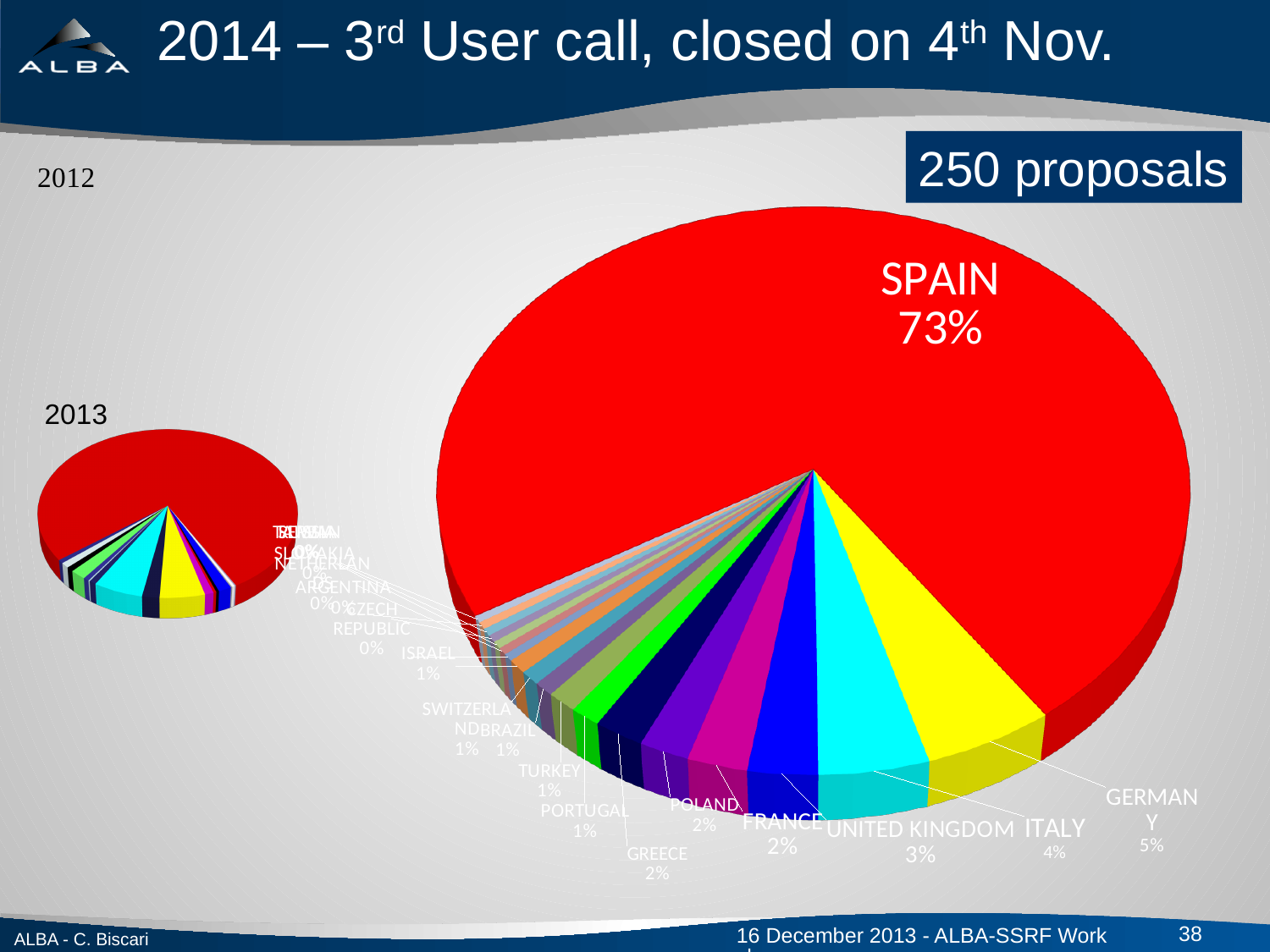
In the large pie chart, what share of proposals comes from Spain? 73% In the large pie chart, what share is labelled for Portugal? 1% In the large pie chart, what share is labelled for Italy? 4% In the large pie chart, which has the larger share, Germany or Italy? Germany In the large pie chart, what share is labelled for Germany? 5% In the large pie chart, what share is labelled for France? 2% How many proposals does the slide say the large pie chart represents? 250 proposals In the large pie chart, what is the difference between Spain's share and Germany's share? 68% What kind of chart is the large chart on the slide? Pie chart In the large pie chart, what is the difference between Italy's share and the United Kingdom's share? 1% In the large pie chart, what share is labelled for the United Kingdom? 3% Which country has the largest slice in the large pie chart? SPAIN